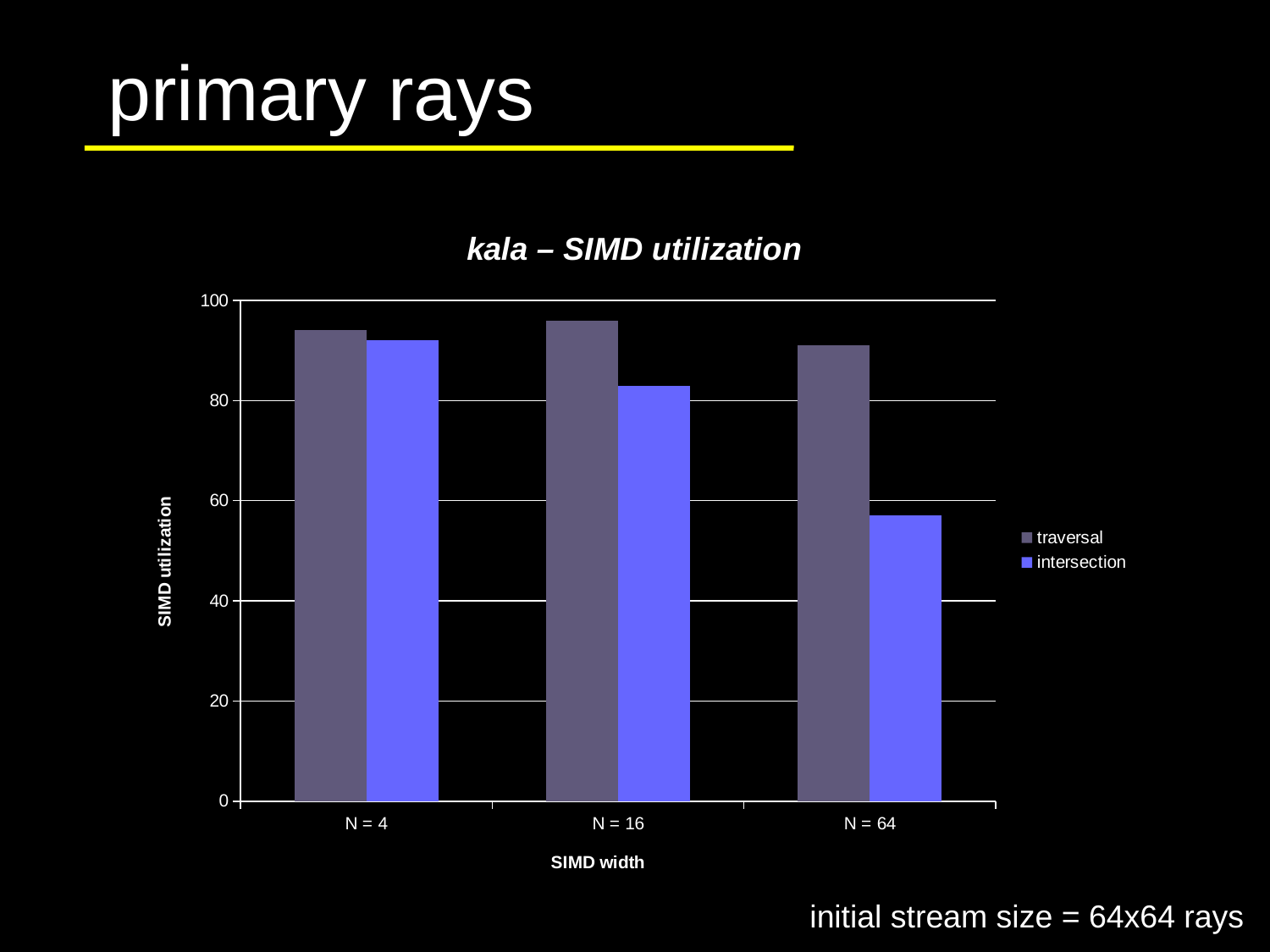
Which series has the lowest value at N = 64? intersection Is the intersection value for N = 64 greater or less than 60? less What is the label of the y axis? SIMD utilization At which SIMD width is the intersection value lowest? N = 64 Do the intersection values rise or fall as SIMD width increases from N = 4 to N = 64? fall How many series does the legend list? 2 Is the traversal value for N = 16 greater or less than 80? greater What is the title of the chart? kala – SIMD utilization How many SIMD width categories are shown on the x axis? 3 What kind of chart is shown on the slide? bar chart At N = 64, which is larger: traversal or intersection? traversal At N = 16, which is larger: traversal or intersection? traversal